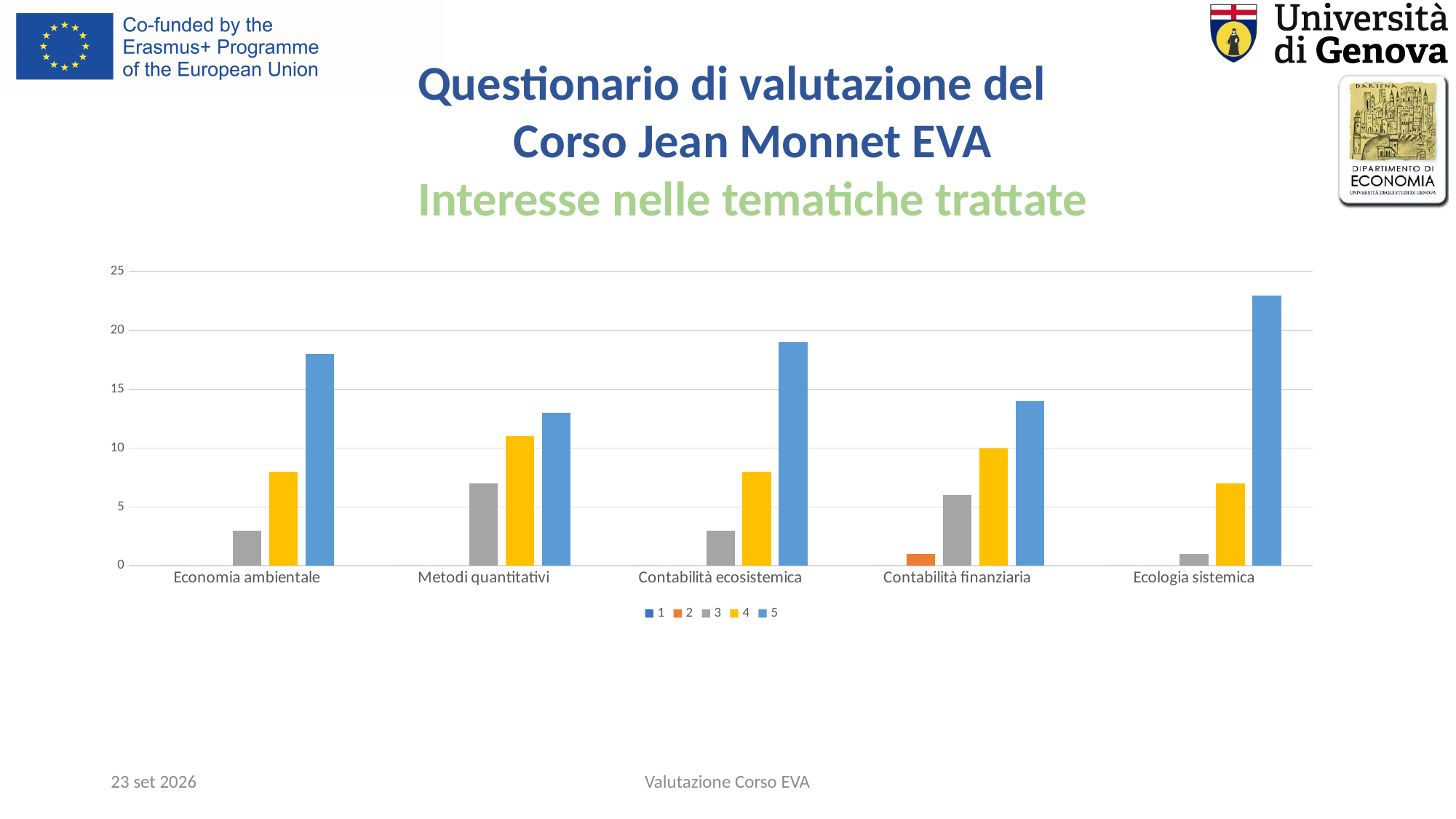
Is the value of series 3 for Economia ambientale greater or less than 5? less What kind of chart is shown on the slide? bar chart How many categories are shown on the x axis of the chart? 5 Is the value of series 5 for Metodi quantitativi greater or less than 15? less Which category has the highest value for series 5? Ecologia sistemica Which category is the only one with a visible bar for series 2? Contabilità finanziaria Is the value of series 5 for Contabilità ecosistemica greater or less than 15? greater Which is larger: the value of series 4 for Metodi quantitativi or for Economia ambientale? Metodi quantitativi How many series does the chart's legend list? 5 Which category has the lowest value for series 3? Ecologia sistemica What is the value of series 4 for Contabilità finanziaria? 10